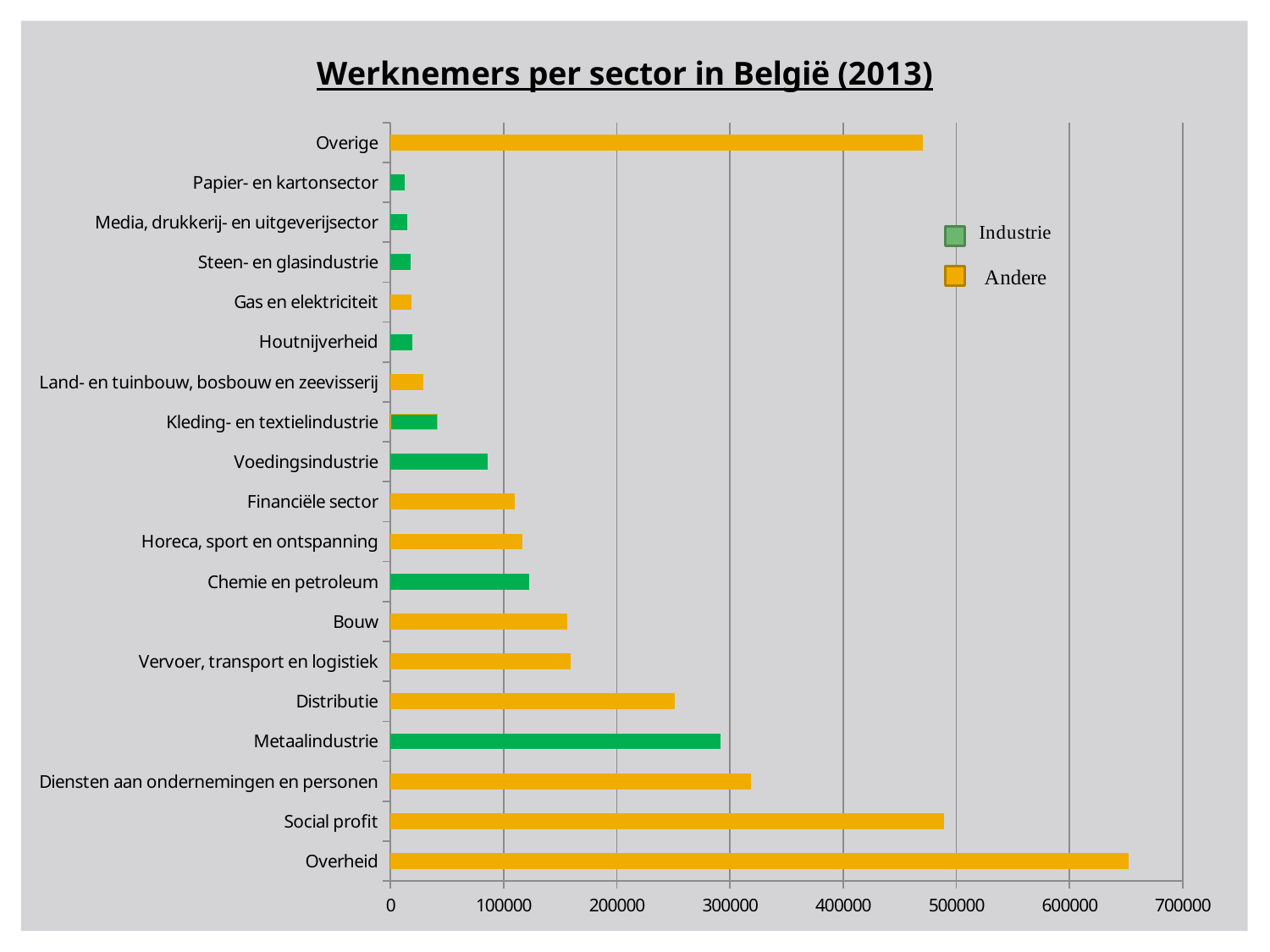
Is the value for Overige greater or less than 500000? less Is the value for Distributie greater or less than 200000? greater Which is larger, the value for Metaalindustrie or the value for Distributie? Metaalindustrie Which colour represents the Industrie series in the legend? green Which is larger, the value for Overheid or the value for Social profit? Overheid What is the title of the chart? Werknemers per sector in België (2013) How many sectors (categories) are plotted in the chart? 19 What kind of chart is shown on the slide? bar chart Is the value for Voedingsindustrie greater or less than 100000? less Which sector has the highest number of employees? Overheid How many series does the legend list? 2